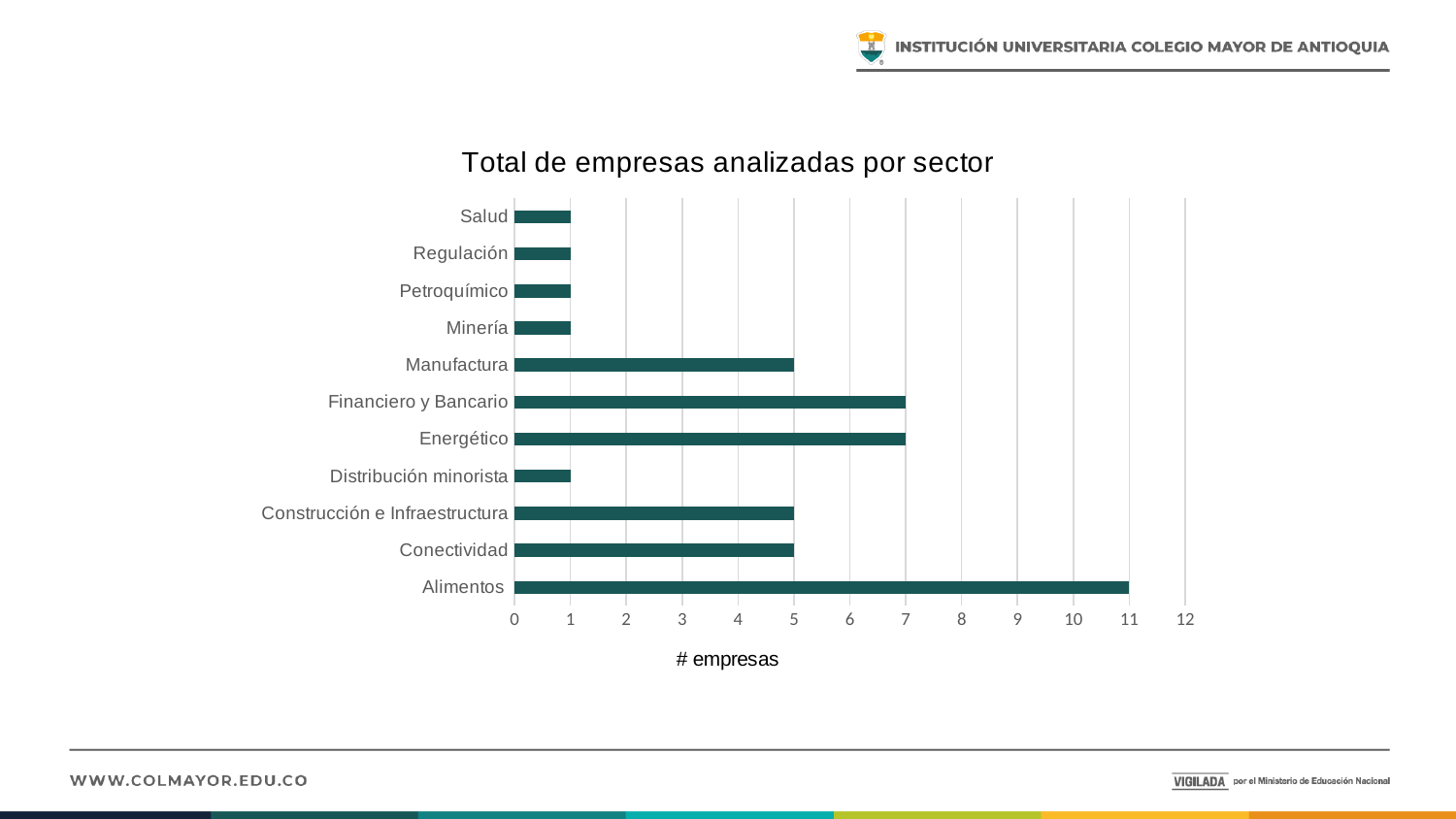
What is the value for Manufactura? 5 What is the value for Alimentos? 11 Is the value for Alimentos greater or less than 10? greater What is the difference between the values for Alimentos and Energético? 4 Which sector has the highest number of companies? Alimentos What kind of chart is shown on the slide? Bar chart How many sectors are shown in the chart? 11 What is the value for Salud? 1 What is the value for Financiero y Bancario? 7 What is the label of the horizontal axis? # empresas What is the title of the chart? Total de empresas analizadas por sector Which is larger, the value for Conectividad or the value for Minería? Conectividad